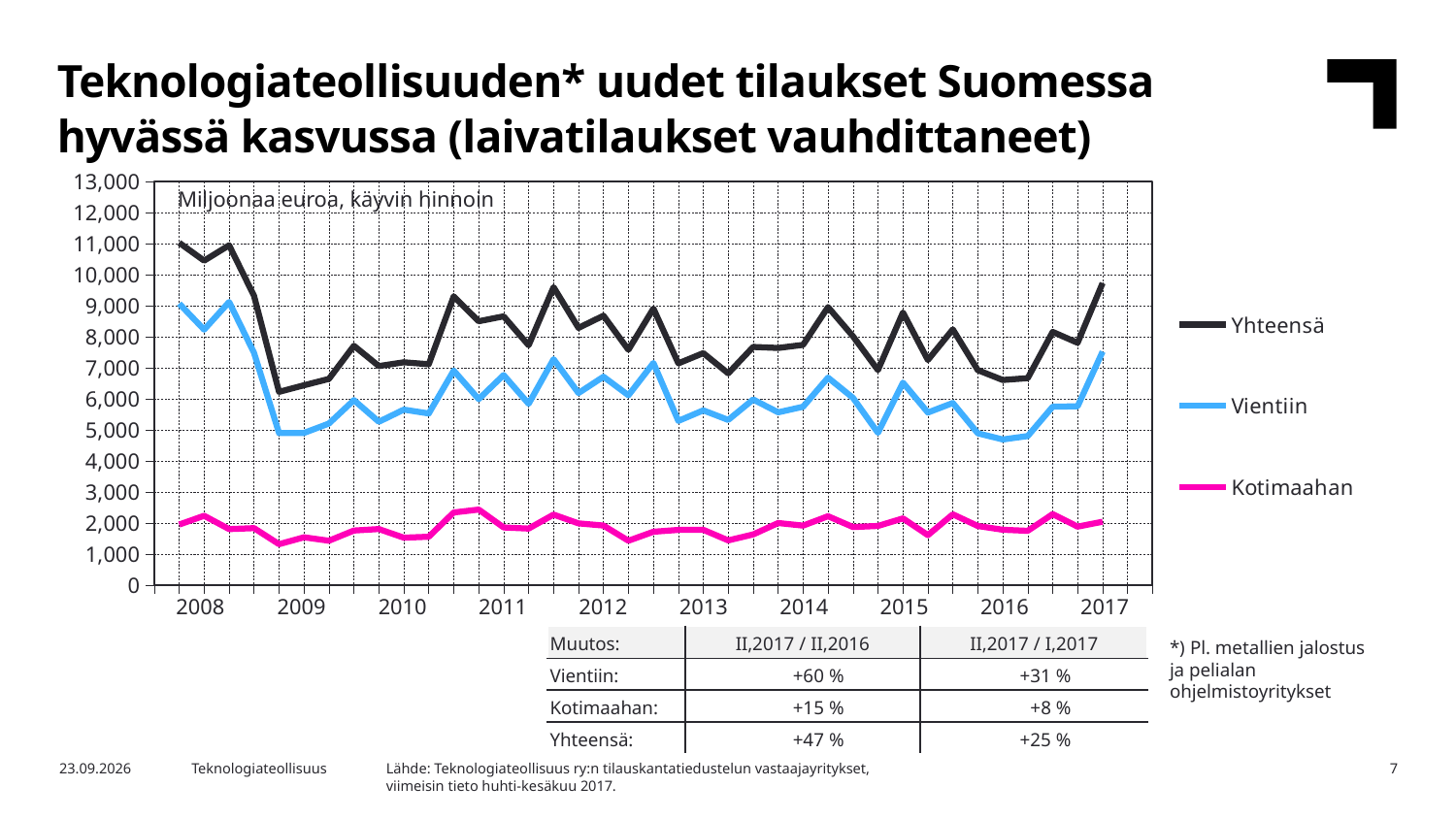
Which series are listed in the chart legend? Yhteensä, Vientiin, Kotimaahan Which series is higher in 2014, Vientiin or Kotimaahan? Vientiin Does the Yhteensä line rise or fall from the start of 2008 to the start of 2009? Fall Is the Kotimaahan value at the end of 2017 greater or less than 3,000? less Is the Yhteensä value at the last point in 2017 greater or less than 9,000? greater How many series does the chart legend list? 3 Which series has the lowest values throughout the chart? Kotimaahan How many year labels are shown on the x axis of the chart? 10 Which series has the highest values throughout the chart? Yhteensä Is the Yhteensä value at the start of 2008 greater or less than 10,000? greater What kind of chart is shown on the slide? Line chart What colour is the Kotimaahan line in the chart? Pink